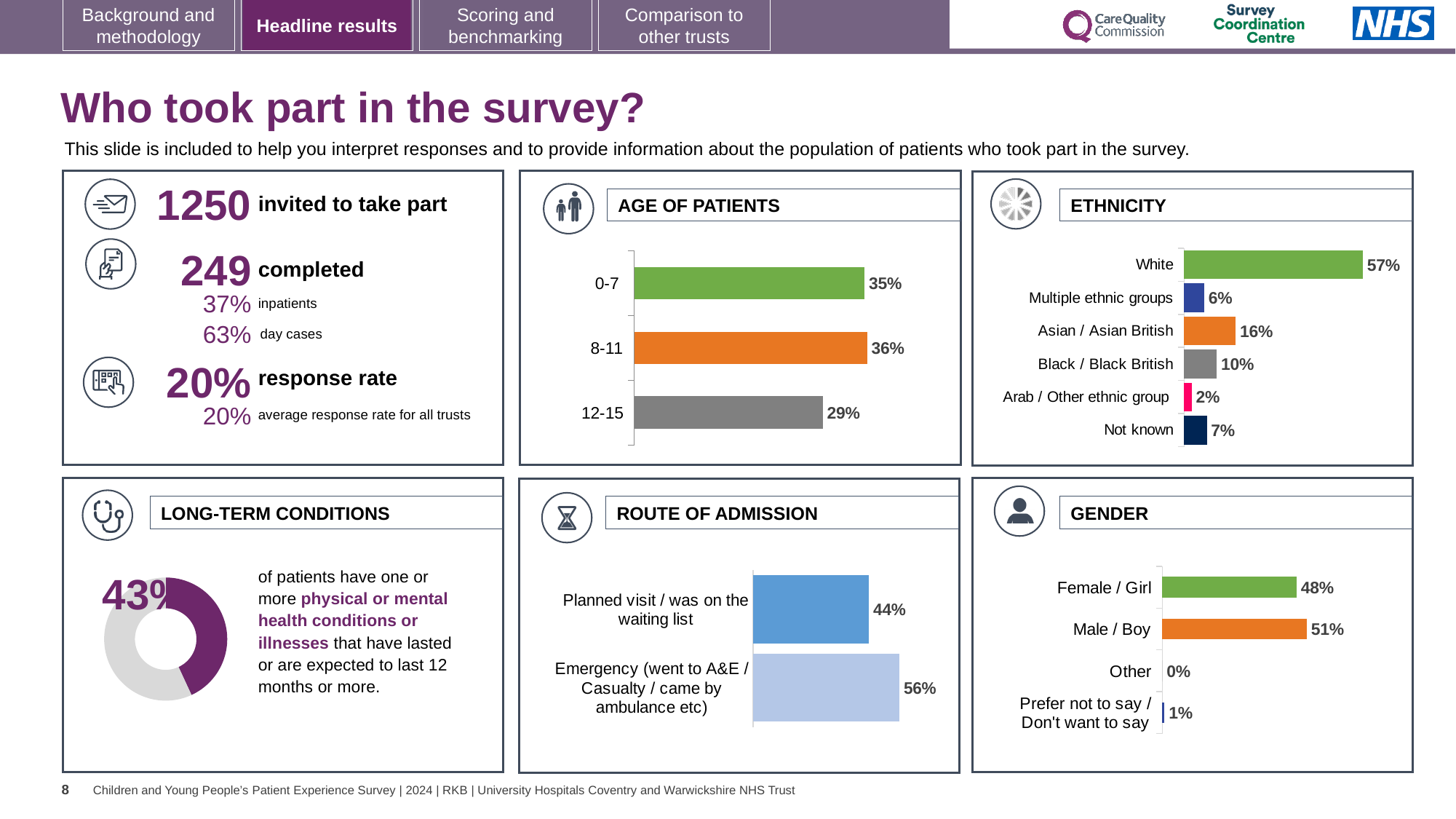
How many ethnic group categories are shown in the ETHNICITY chart? 6 In the AGE OF PATIENTS chart, what percentage of patients were aged 8-11? 36% In the ROUTE OF ADMISSION chart, which route has the larger percentage: Planned visit / was on the waiting list or Emergency? Emergency (went to A&E / Casualty / came by ambulance etc) In the LONG-TERM CONDITIONS chart, what percentage of patients have one or more long-term conditions? 43% In the ETHNICITY chart, what is the difference between the Asian / Asian British and Black / Black British percentages? 6% What type of chart is used in the LONG-TERM CONDITIONS panel? Doughnut chart In the ETHNICITY chart, what percentage of patients were White? 57% In the ETHNICITY chart, which ethnic group has the lowest percentage? Arab / Other ethnic group In the ROUTE OF ADMISSION chart, what percentage of patients came via Emergency (went to A&E / Casualty / came by ambulance etc)? 56% In the AGE OF PATIENTS chart, which age group has the lowest percentage? 12-15 In the GENDER chart, what percentage of patients were Male / Boy? 51% In the GENDER chart, what is the difference between the Male / Boy and Female / Girl percentages? 3%